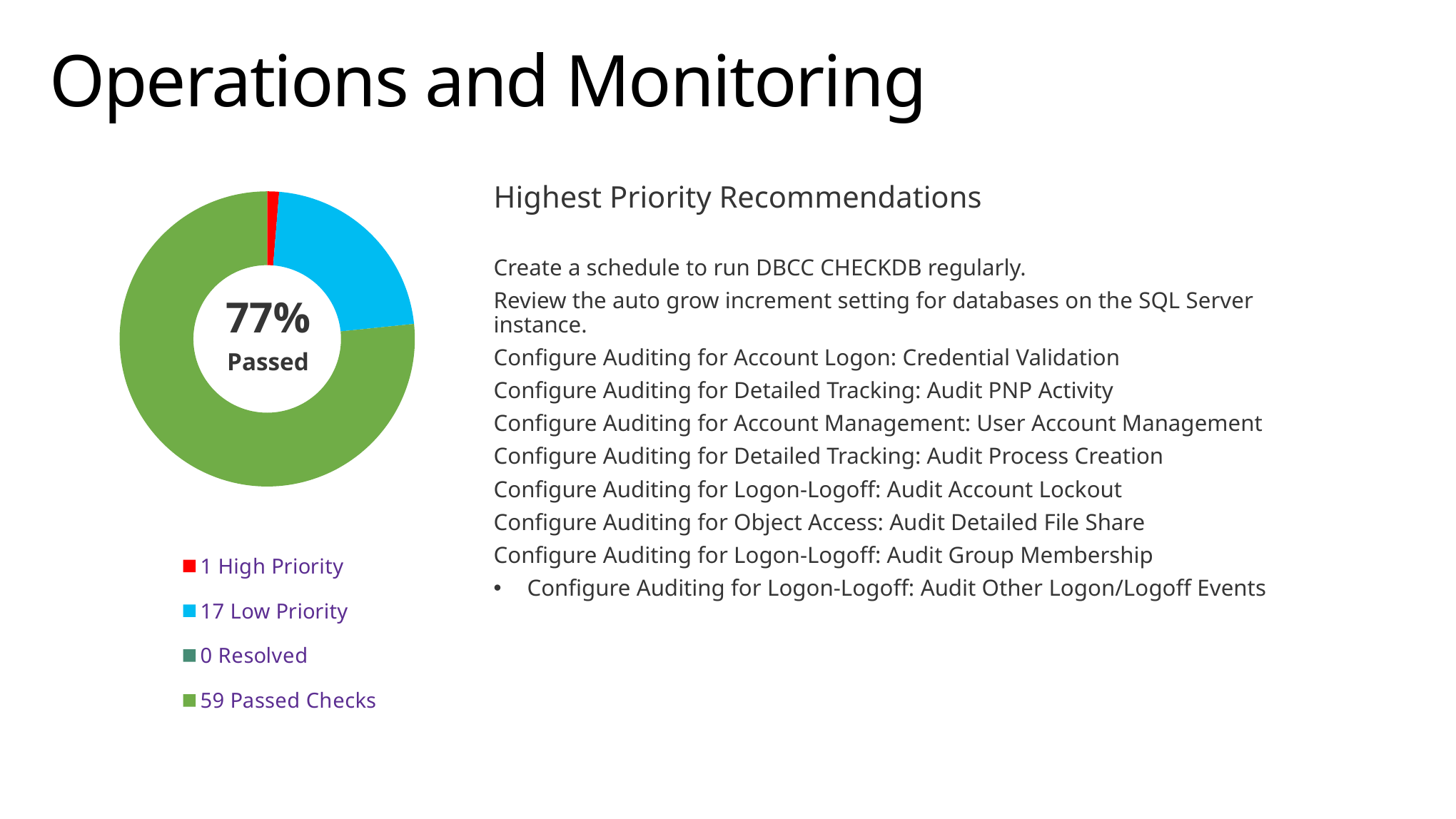
What kind of chart is shown on the slide? doughnut chart How many checks are Resolved according to the chart legend? 0 How many Passed Checks does the chart legend show? 59 What is the difference between the number of Passed Checks and the number of Low Priority checks? 42 Which category has the largest value in the chart? Passed Checks How many checks are High Priority according to the chart legend? 1 What percentage of checks passed, as shown in the centre of the chart? 77% Which category has the smallest value in the chart? Resolved How many checks are Low Priority according to the chart legend? 17 How many categories does the chart legend list? 4 Which is larger, the number of Low Priority checks or the number of High Priority checks? Low Priority What colour represents Passed Checks in the chart? green